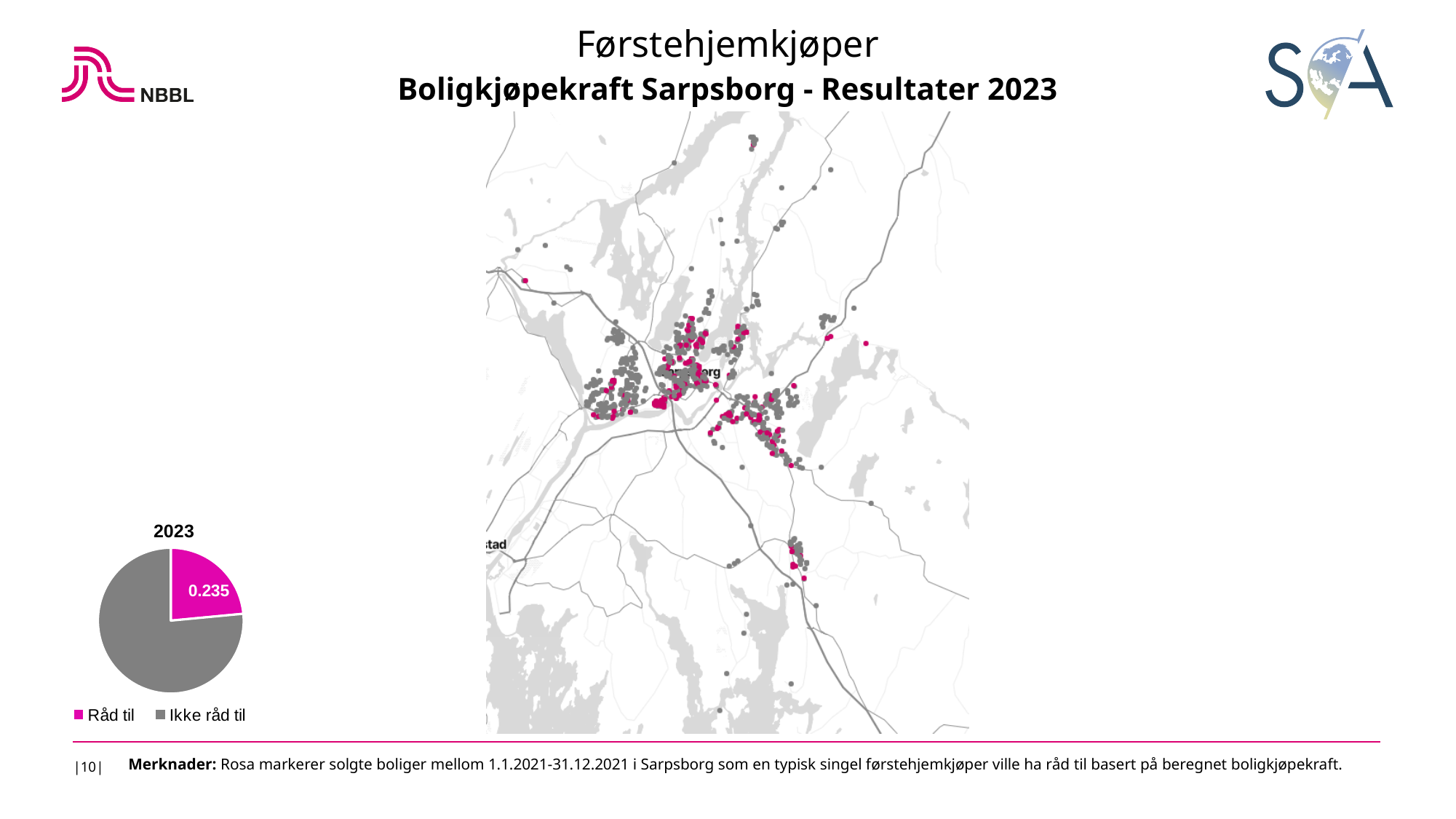
What is the title shown above the pie chart? 2023 What kind of chart is the chart on the left of the slide? pie chart In the pie chart's legend, which category is shown in pink? Råd til How many entries does the pie chart's legend list? 2 How many slices does the pie chart have? 2 What share of the pie does the "Råd til" slice represent? 0.235 In the pie chart, what value is shown for the "Råd til" slice? 0.235 In the pie chart, which slice is larger: "Råd til" or "Ikke råd til"? Ikke råd til In the pie chart, which category has the largest slice? Ikke råd til In the pie chart, which category has the smallest slice? Råd til